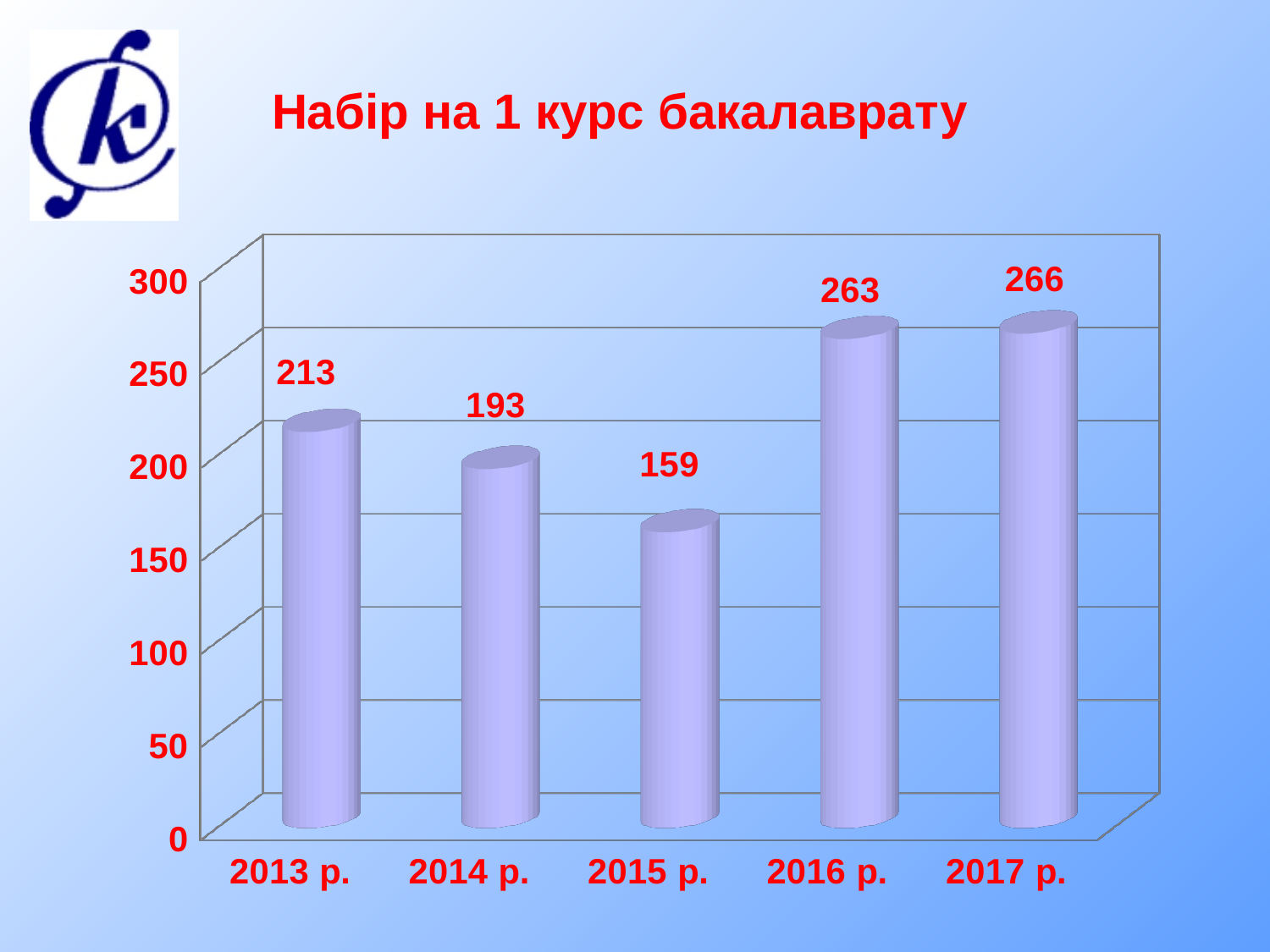
Is the value for 2016 р. greater or less than 250? greater How many years are shown on the x axis? 5 Which year has the highest value? 2017 р. Which is larger, the value for 2013 р. or the value for 2014 р.? 2013 р. Which year has the lowest value? 2015 р. What is the value for 2015 р.? 159 What is the title of the chart? Набір на 1 курс бакалаврату What is the difference between the values for 2013 р. and 2014 р.? 20 What kind of chart is shown on the slide? bar chart What is the value for 2017 р.? 266 What is the difference between the values for 2016 р. and 2015 р.? 104 What is the value for 2013 р.? 213